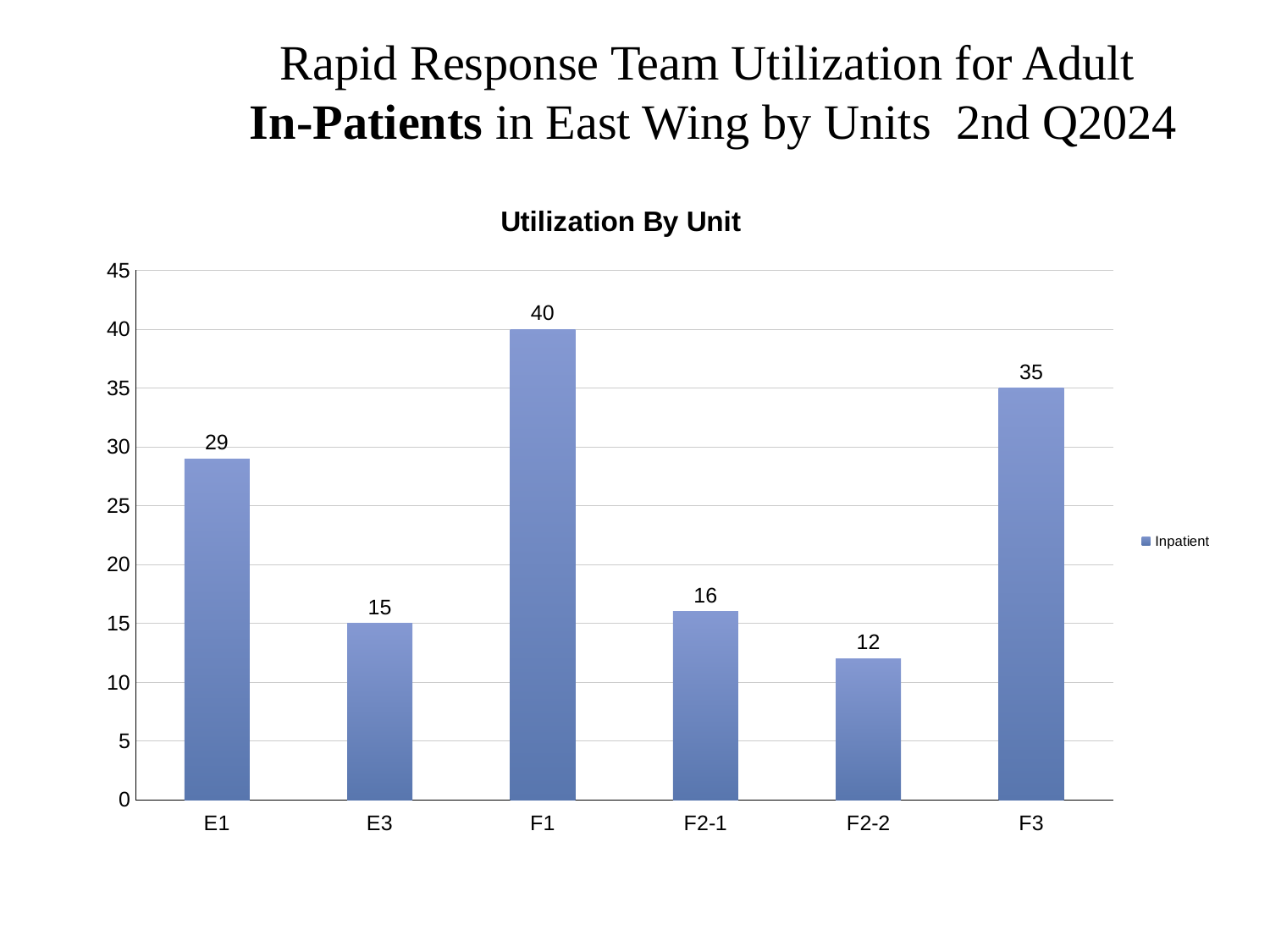
Which is larger, the value for F2-1 or the value for E3? F2-1 How many series does the legend list? 1 How many units are shown on the x axis? 6 Is the value for F3 greater or less than 30? greater Which unit has the lowest value? F2-2 What is the difference between the values for E1 and E3? 14 What is the value for unit E1? 29 What is the difference between the values for F1 and F3? 5 What is the value for unit F2-2? 12 Which unit has the highest value? F1 What kind of chart is shown? bar chart What is the value for unit F1? 40